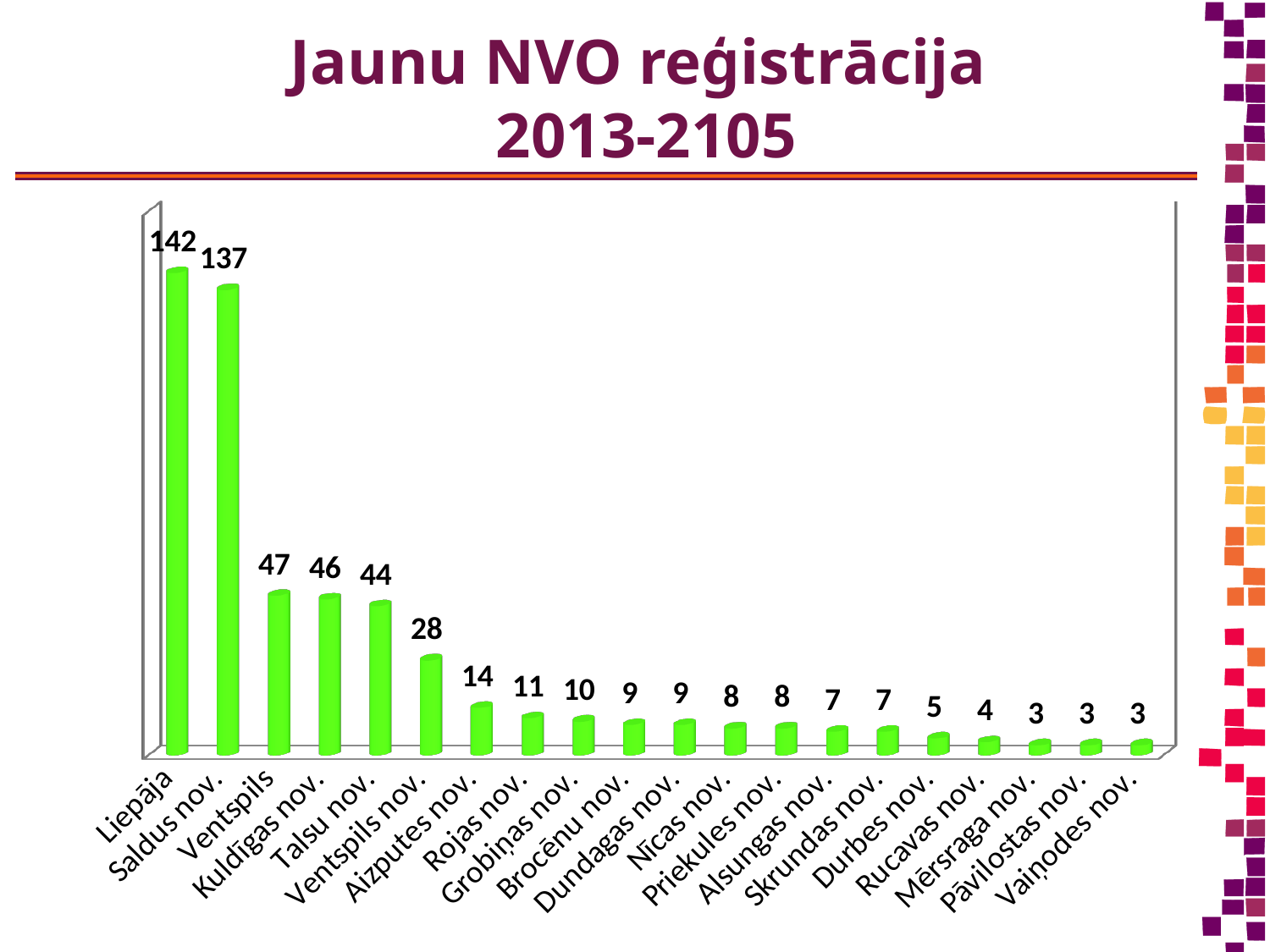
Which is larger, the value for Ventspils or the value for Kuldīgas nov.? Ventspils What is the value for Durbes nov.? 5 Which category has the highest value? Liepāja What is the lowest value shown in the chart? 3 How many categories are shown in the chart? 20 What is the value for Ventspils nov.? 28 What kind of chart is shown on the slide? Bar chart What is the value for Aizputes nov.? 14 What is the difference between the values for Ventspils and Ventspils nov.? 19 What is the difference between the values for Liepāja and Saldus nov.? 5 Do the values rise or fall from left to right along the x axis? Fall What is the value for Liepāja? 142